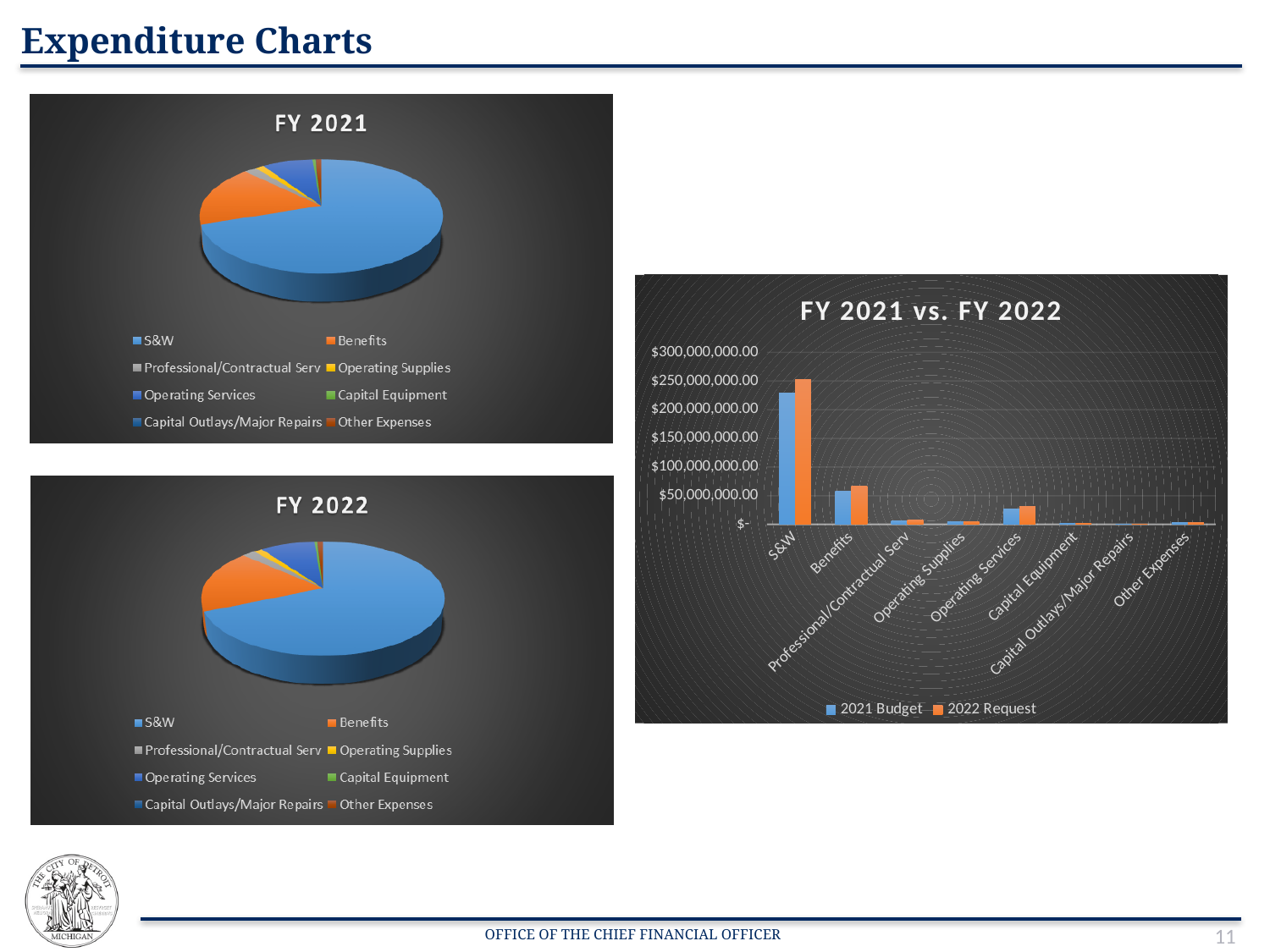
In the FY 2021 vs. FY 2022 chart, which is larger for S&W: the 2021 Budget or the 2022 Request? 2022 Request In the FY 2021 vs. FY 2022 chart, which category has the highest values? S&W In the FY 2021 vs. FY 2022 chart, which category has the larger 2022 Request: Benefits or Operating Services? Benefits What kind of chart is the FY 2021 chart on the left? Pie chart In the FY 2021 vs. FY 2022 chart, is the 2021 Budget value for Benefits greater or less than $100,000,000.00? less In the FY 2021 vs. FY 2022 chart, is the 2021 Budget value for S&W greater or less than $200,000,000.00? greater In the FY 2021 vs. FY 2022 chart, is the 2022 Request value for Operating Services greater or less than $50,000,000.00? less In the FY 2021 pie chart, which category has the largest slice? S&W In the FY 2021 vs. FY 2022 chart, how many series does the legend list? 2 In the FY 2021 vs. FY 2022 chart, how many expenditure categories are shown on the x axis? 8 What kind of chart is the FY 2021 vs. FY 2022 chart on the right? Bar chart In the FY 2022 pie chart, which category has the second-largest slice? Benefits